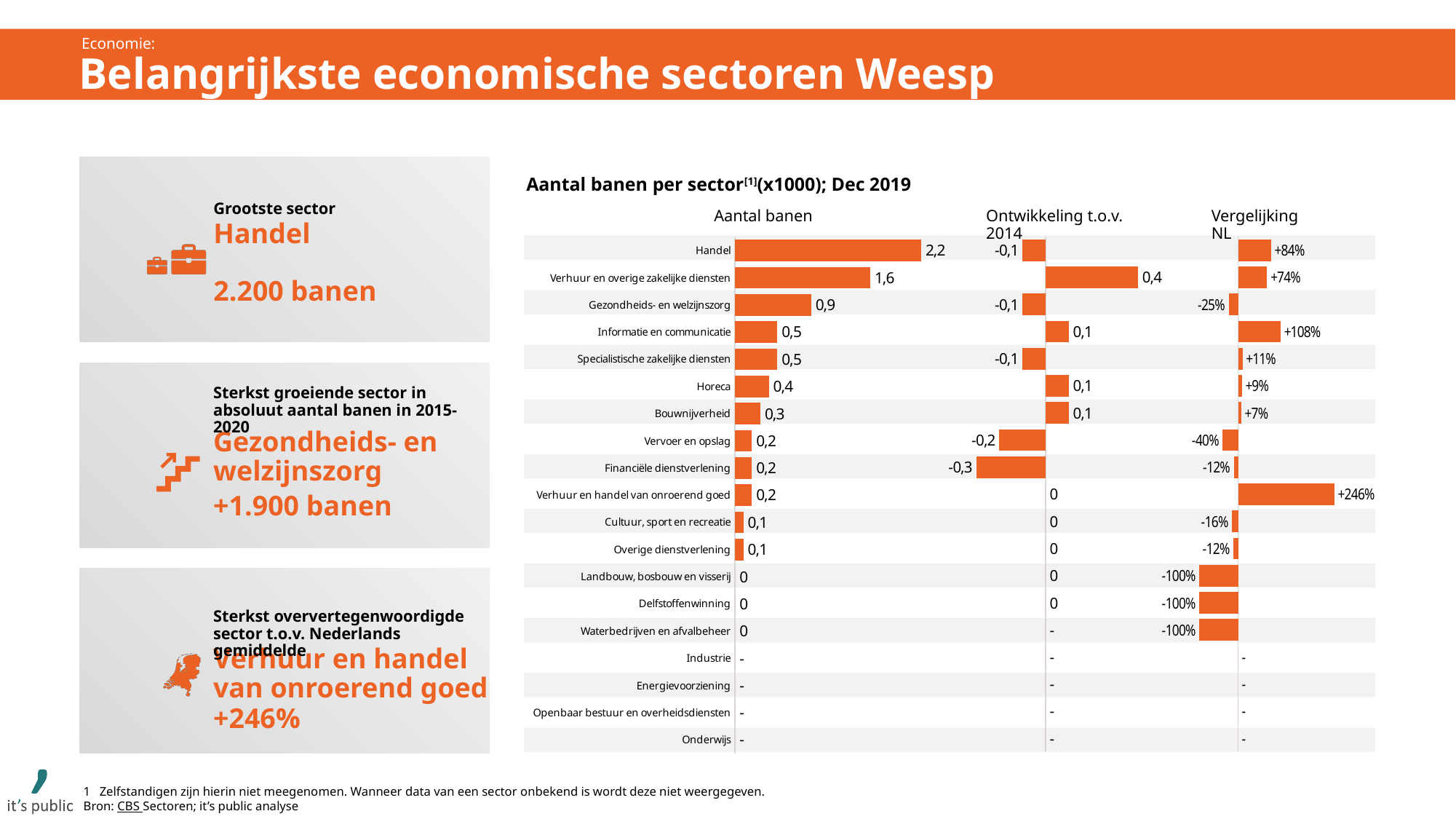
Which sector has the highest value in the 'Vergelijking NL' column? Verhuur en handel van onroerend goed In the 'Aantal banen' column, what is the difference between Handel and Verhuur en overige zakelijke diensten? 0,6 In the 'Ontwikkeling t.o.v. 2014' column, what is the value for Verhuur en overige zakelijke diensten? 0,4 In the 'Vergelijking NL' column, what is the value for Verhuur en handel van onroerend goed? +246% In the 'Aantal banen' column, what is the value for Gezondheids- en welzijnszorg? 0,9 Which sector has the highest value in the 'Aantal banen' column? Handel In the 'Aantal banen' column, what is the value for Handel? 2,2 In the 'Vergelijking NL' column, what is the value for Vervoer en opslag? -40% Which sector has the lowest value in the 'Ontwikkeling t.o.v. 2014' column? Financiële dienstverlening What kind of chart is used to show the values on this slide? Bar chart What is the title of the chart on the slide? Aantal banen per sector (x1000); Dec 2019 In the 'Vergelijking NL' column, which is larger: Handel or Informatie en communicatie? Informatie en communicatie